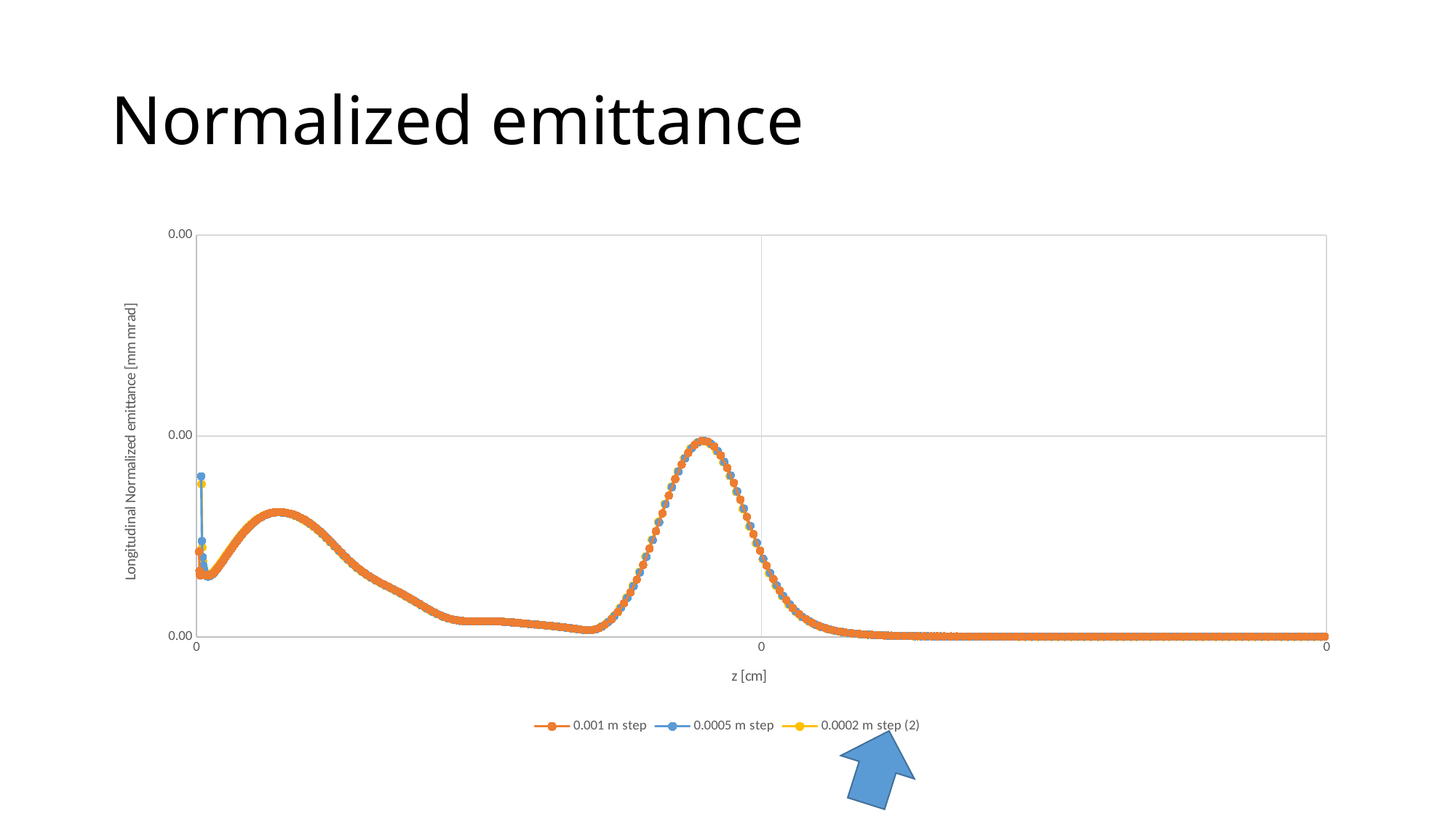
What is the title of the x axis? z [cm] After the tallest peak, does the line rise or fall toward the right edge of the chart? fall What are the three series names listed in the legend? 0.001 m step, 0.0005 m step, 0.0002 m step (2) How many series does the legend list? 3 What kind of chart is shown on the slide? line chart